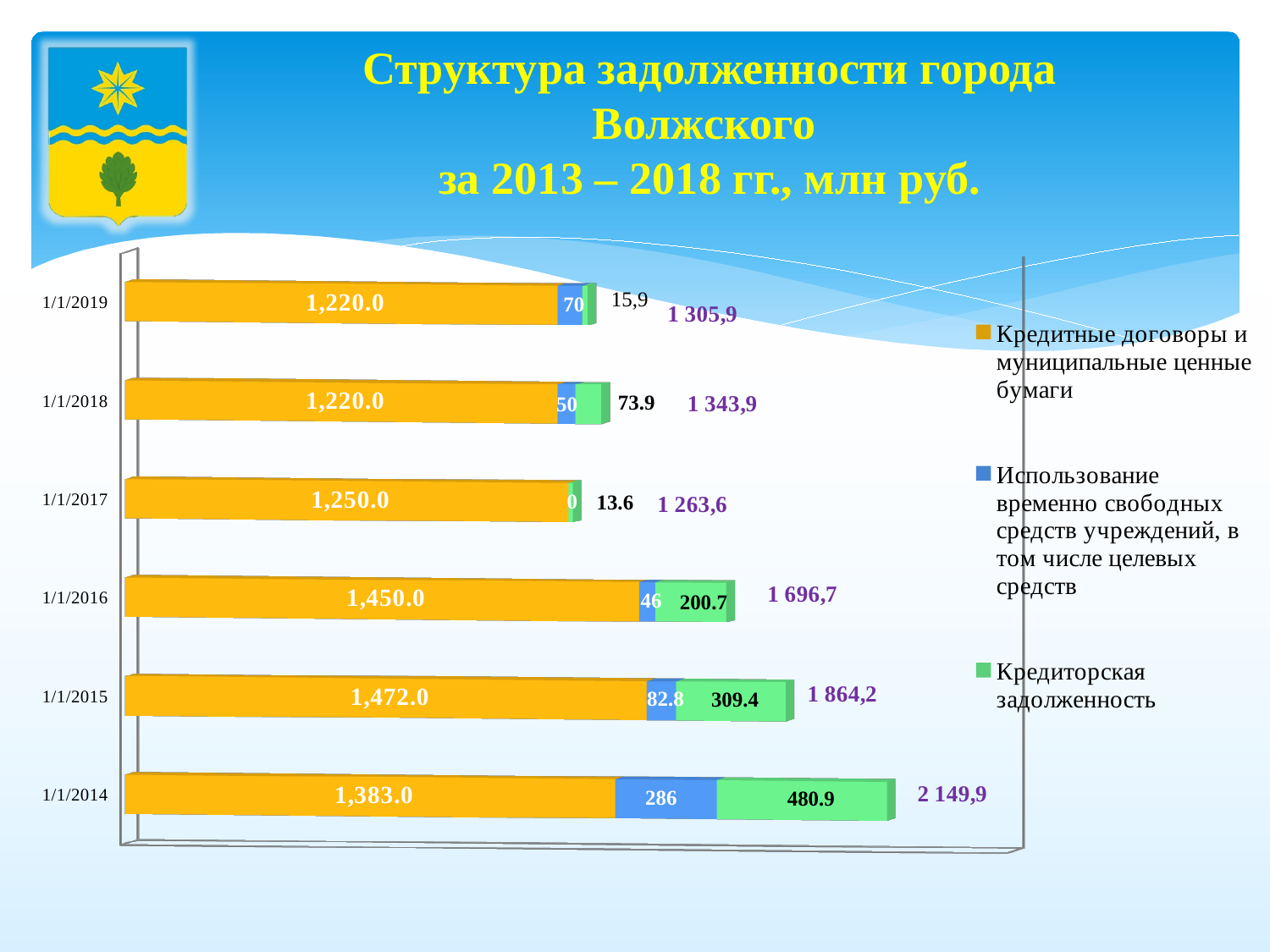
What kind of chart is shown on the slide? Stacked bar chart What is the value of 'Кредитные договоры и муниципальные ценные бумаги' for 1/1/2014? 1,383.0 Which colour represents 'Кредиторская задолженность' in the chart? Green Which is larger: the 'Использование временно свободных средств' value for 1/1/2019 or for 1/1/2018? 1/1/2019 What is the value of 'Использование временно свободных средств учреждений, в том числе целевых средств' for 1/1/2016? 46 How many series does the legend list? 3 Which date has the highest value for 'Кредиторская задолженность'? 1/1/2014 How many dates (categories) are shown on the chart? 6 Which date has the lowest value for 'Кредитные договоры и муниципальные ценные бумаги'? 1/1/2018 and 1/1/2019 (both 1,220.0) What is the difference between the 'Кредиторская задолженность' values for 1/1/2014 and 1/1/2015? 171.5 What is the total debt shown for 1/1/2018? 1 343,9 What is the value of 'Кредиторская задолженность' for 1/1/2015? 309.4